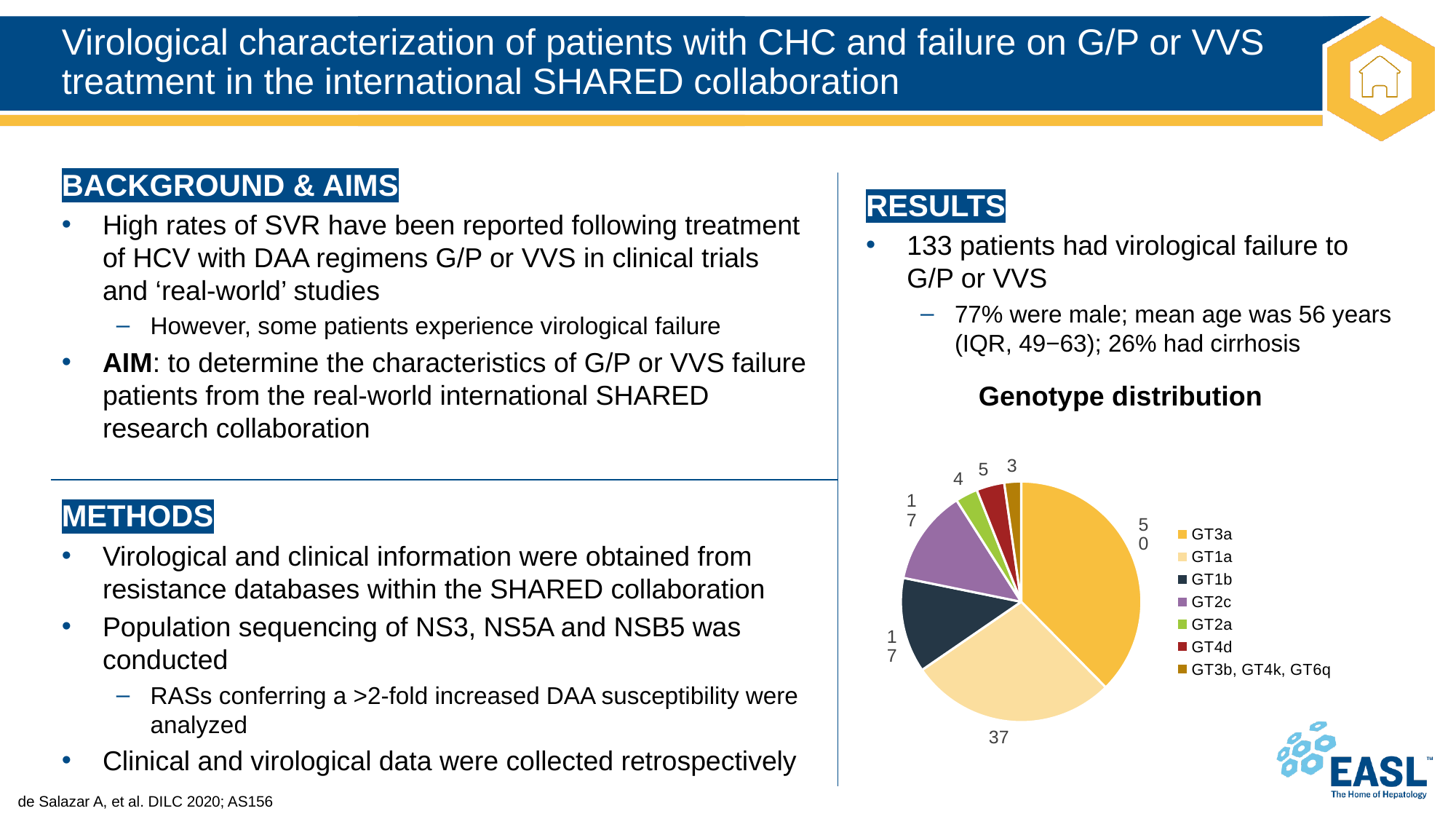
Which genotype has the largest slice in the Genotype distribution chart? GT3a In the Genotype distribution chart, what is the value for GT1a? 37 In the Genotype distribution chart, what is the difference between the GT3a and GT1a values? 13 In the Genotype distribution chart, what is the value for GT3a? 50 What kind of chart is used to show the genotype distribution? pie chart How many slices does the Genotype distribution pie chart have? 7 In the Genotype distribution chart, what is the value for the GT3b, GT4k, GT6q slice? 3 Which slice is the smallest in the Genotype distribution chart? GT3b, GT4k, GT6q In the Genotype distribution chart, which is larger, GT2a or GT4d? GT4d In the Genotype distribution chart, what is the value for GT2a? 4 What is the title of the pie chart on the slide? Genotype distribution In the Genotype distribution chart, what is the value for GT4d? 5